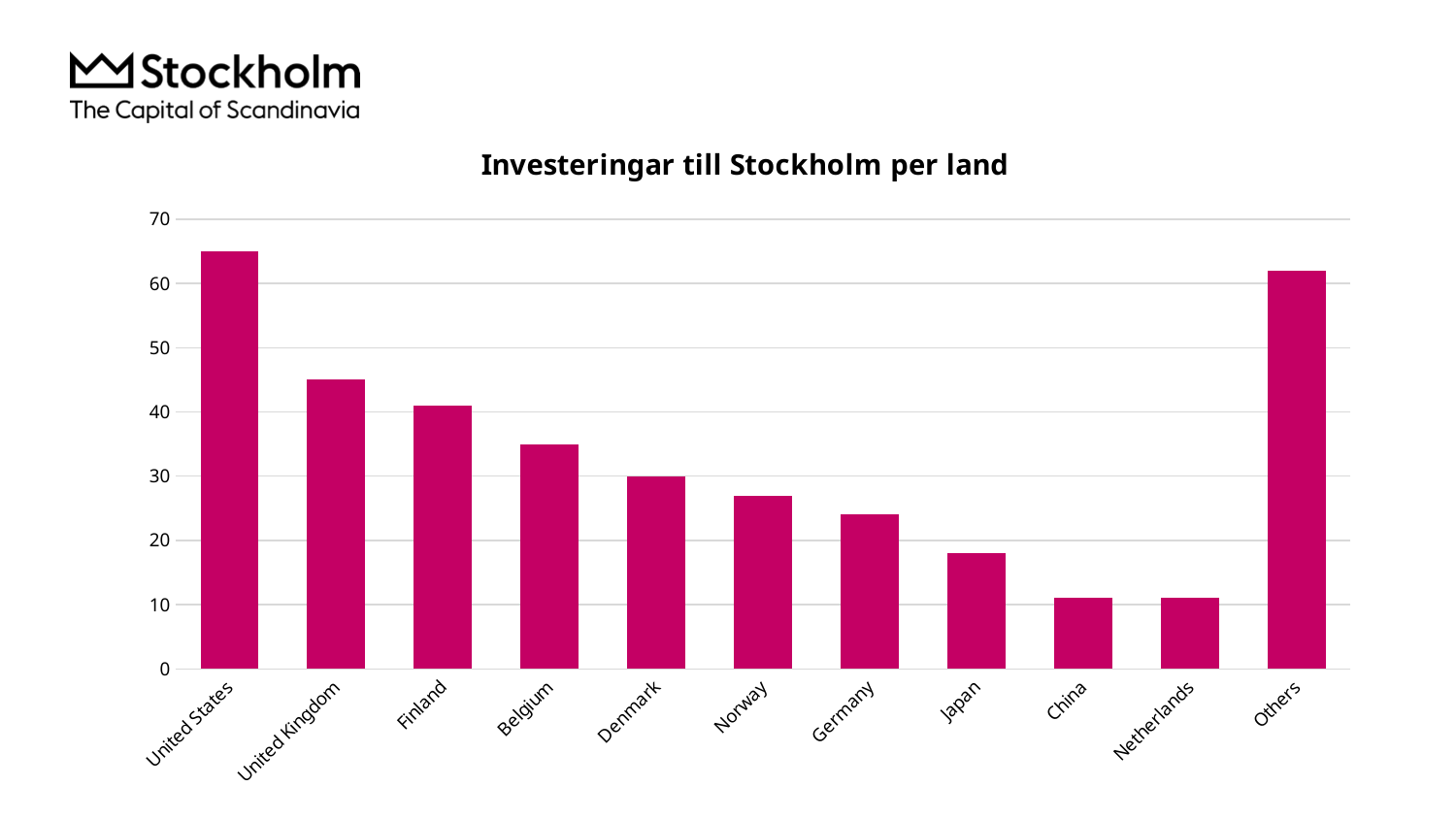
Is the value for Others greater or less than 60? greater Is the value for United Kingdom greater or less than 50? less Which is larger, the value for Others or the value for United Kingdom? Others What is the title of the chart? Investeringar till Stockholm per land How many categories are shown on the x axis of the chart? 11 Which category has the highest value in the chart? United States Is the value for Japan greater or less than 20? less Do the values rise or fall from United States to Netherlands along the x axis? fall What type of chart is shown on the slide? bar chart Which is larger, the value for Belgium or the value for Germany? Belgium